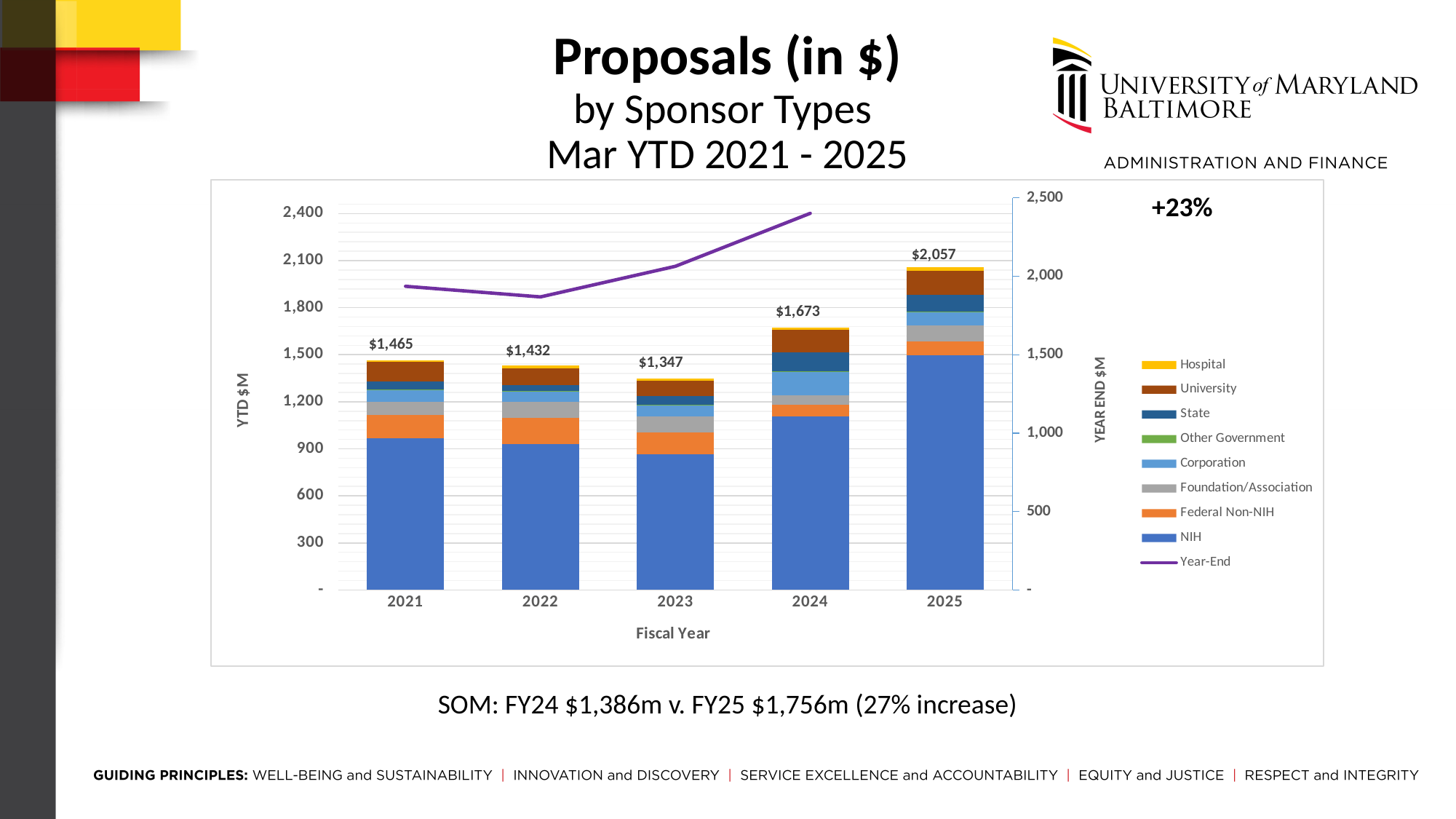
What is the total YTD proposal value labeled for fiscal year 2025? $2,057 Is the NIH value for 2025 greater or less than 1,200 on the YTD $M axis? greater Which fiscal year has a larger total YTD value, 2021 or 2022? 2021 What is the difference between the total YTD values for 2025 and 2024? $384 Is the NIH value for 2021 greater or less than 1,200 on the YTD $M axis? less What kind of chart is used to show the sponsor types? Stacked bar chart How many fiscal years are shown on the x axis? 5 Which fiscal year has the lowest total YTD proposal value? 2023 What is the total YTD proposal value labeled for fiscal year 2023? $1,347 Which fiscal year has the highest total YTD proposal value? 2025 How many entries does the legend list? 9